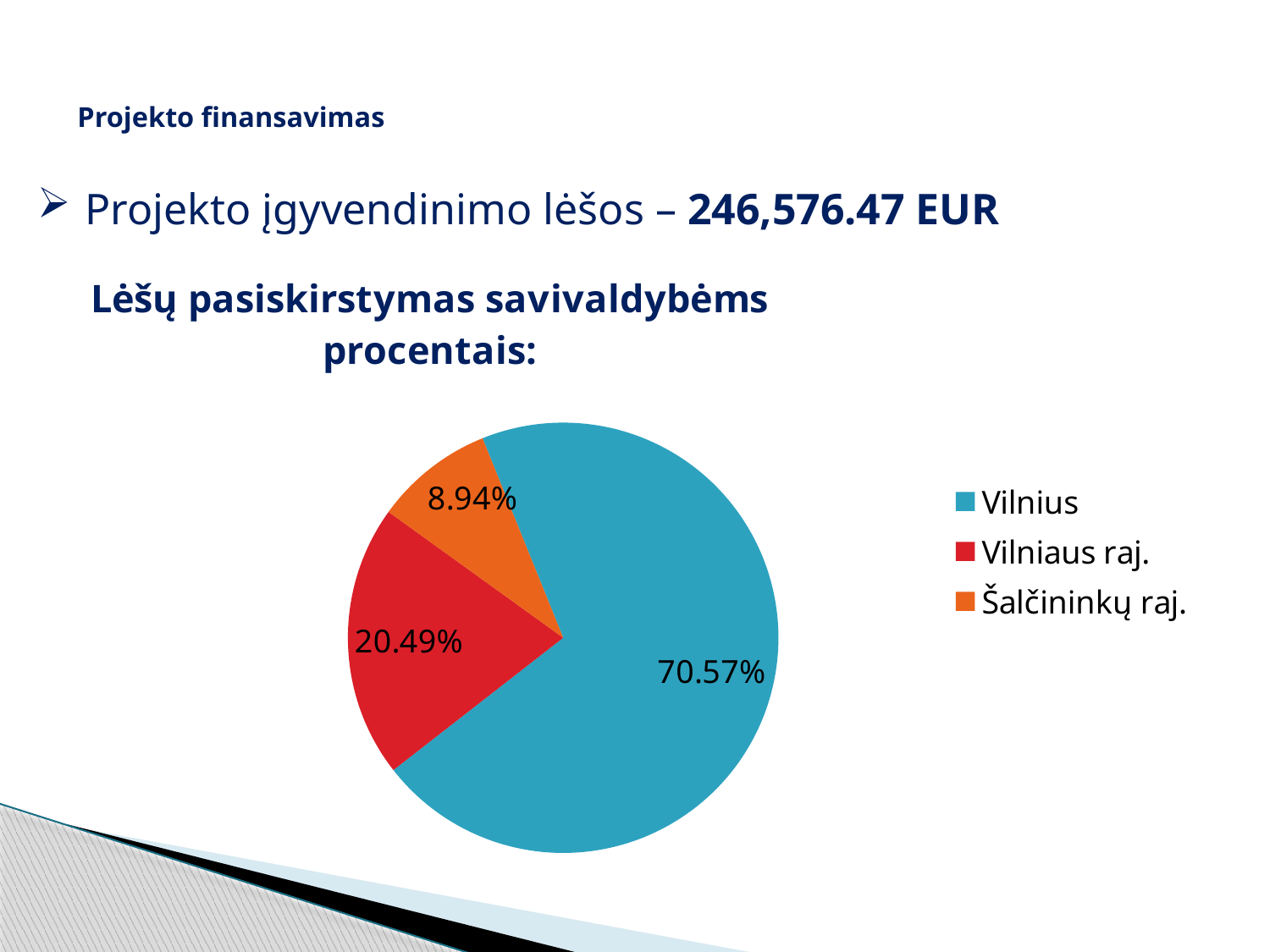
What is the difference in percentage points between the Vilnius slice and the Vilniaus raj. slice? 50.08 Which municipality has the smallest slice of the pie? Šalčininkų raj. How many slices does the pie chart have? 3 How many entries does the legend list? 3 What colour is the Vilnius slice in the pie chart? blue Which slice is larger, Vilniaus raj. or Šalčininkų raj.? Vilniaus raj. What share of the pie does Vilniaus raj. have? 20.49% Which municipality has the largest slice of the pie? Vilnius What share of the pie does Šalčininkų raj. have? 8.94% What is the title shown above the pie chart? Lėšų pasiskirstymas savivaldybėms procentais: What kind of chart is shown on the slide? pie chart What share of the pie does Vilnius have? 70.57%